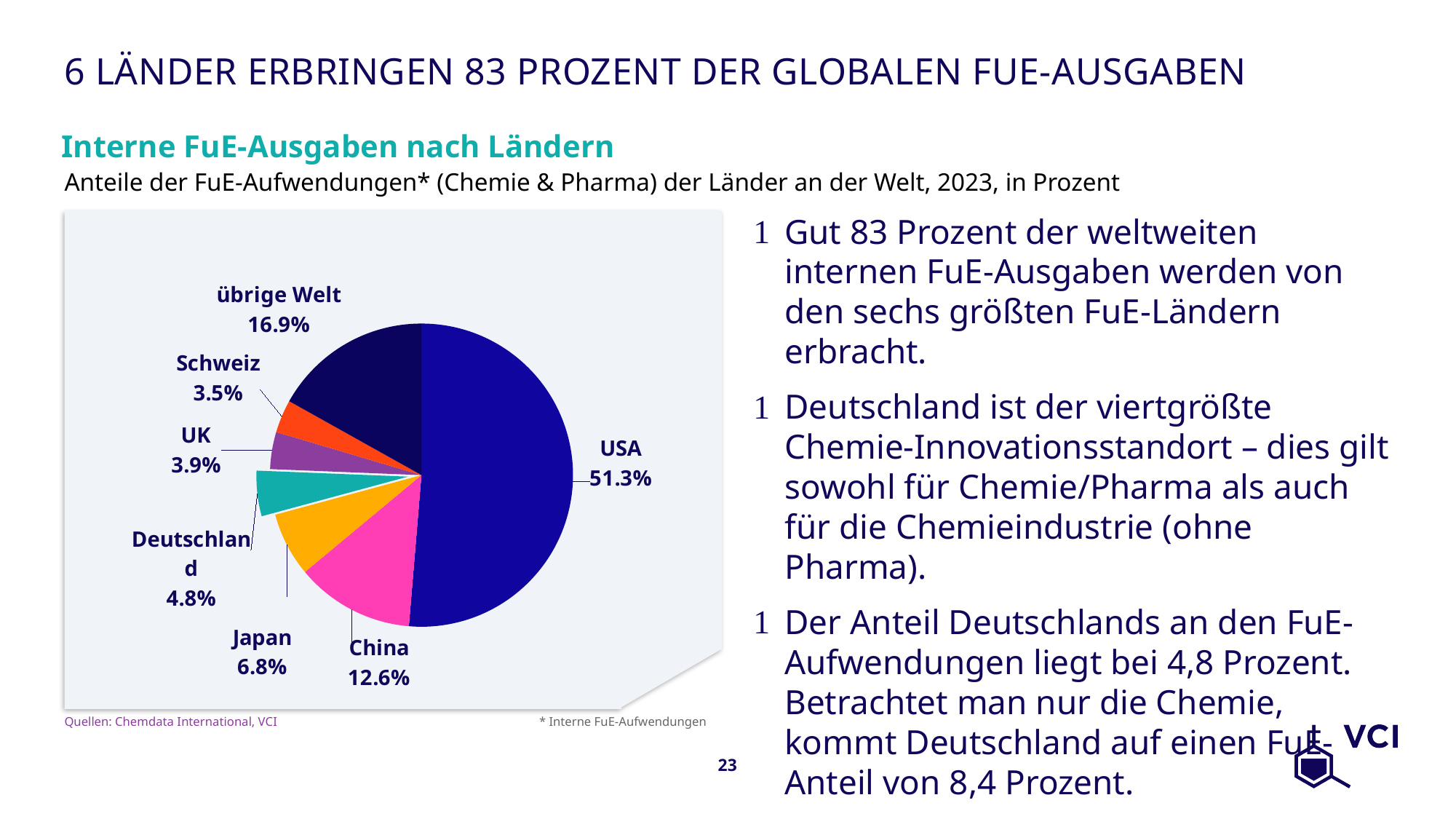
What is the value shown for China? 12.6% What is the value shown for übrige Welt? 16.9% How many slices does the pie chart have? 7 What is the title of the chart? Interne FuE-Ausgaben nach Ländern What is the combined share of Japan and Deutschland? 11.6% Which category has the largest slice of the pie? USA What kind of chart is shown on the slide? Pie chart What share of the pie does the USA hold? 51.3% Which is larger, the share of UK or the share of Schweiz? UK Which category has the smallest slice of the pie? Schweiz What is the value shown for Deutschland? 4.8% What is the difference between the shares of China and Japan? 5.8%